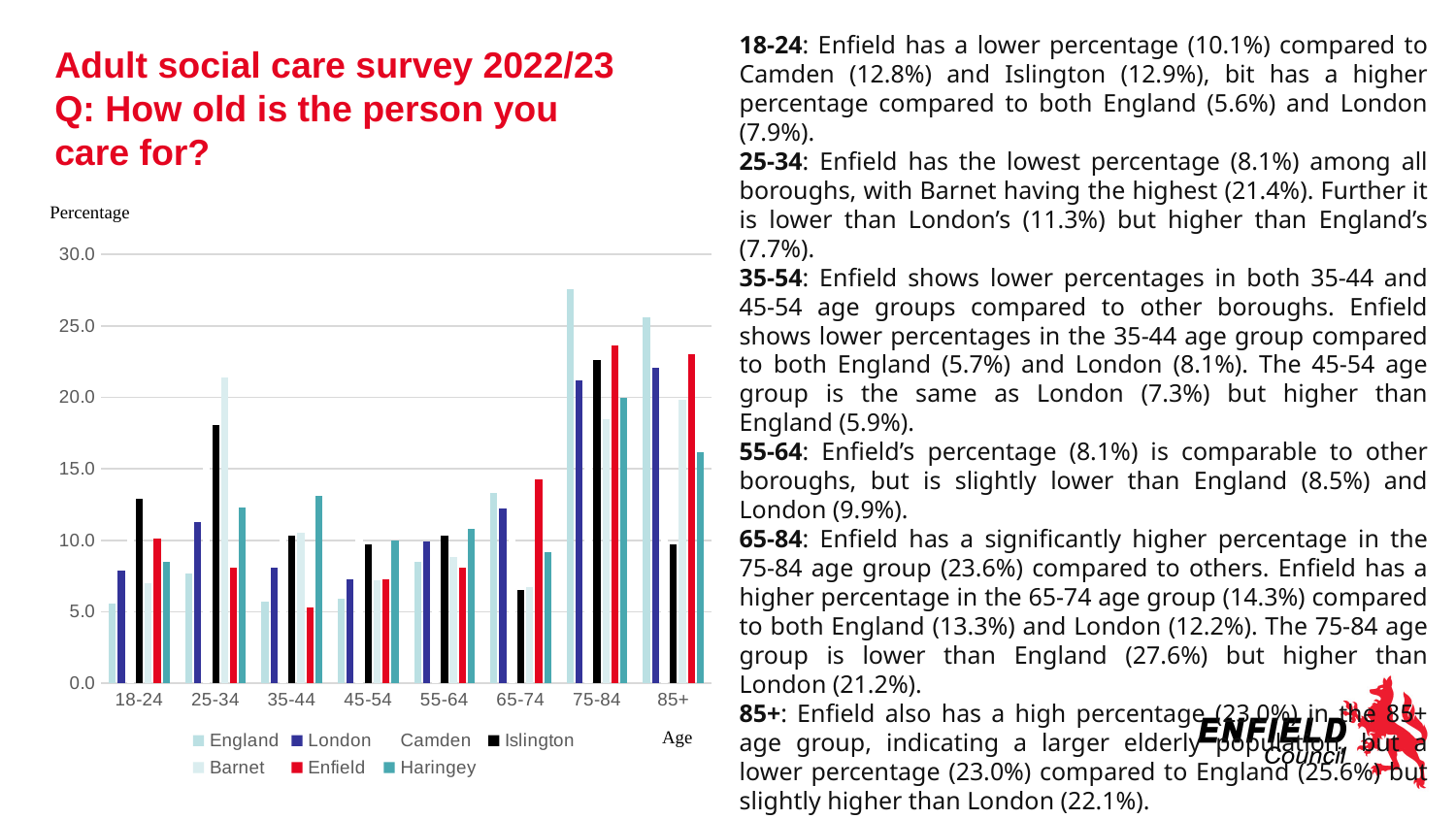
Is the value for Islington in the 25-34 age group greater or less than 15.0? greater Which borough has the highest percentage in the 25-34 age group? Barnet How many series does the chart legend list? 7 Which age group has the lowest percentage for Enfield? 35-44 What is the difference between Enfield's and London's percentages for the 75-84 age group? 2.4 percentage points What is the label on the vertical axis of the chart? Percentage How many age groups are shown on the x axis of the chart? 8 What is Enfield's percentage for the 75-84 age group? 23.6% In the 65-74 age group, which is larger: Enfield's percentage or England's? Enfield What is England's percentage for the 18-24 age group? 5.6% Is the value for Haringey in the 85+ age group greater or less than 20.0? less What type of chart is shown on the slide? Bar chart